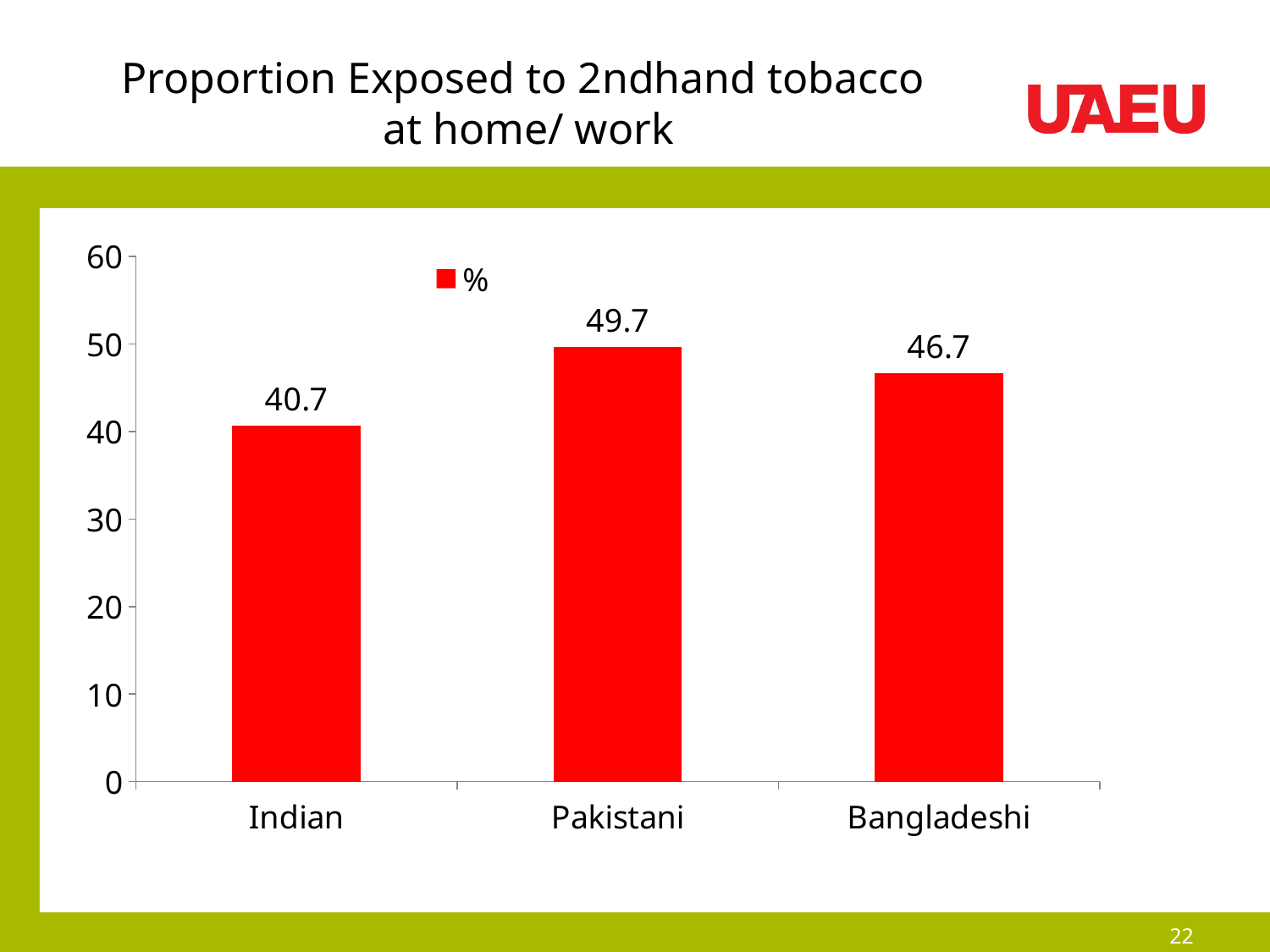
What is the difference between the values for Pakistani and Indian? 9 What is the value for Pakistani? 49.7 What is the value for Bangladeshi? 46.7 Is the value for Pakistani greater or less than 50? less What kind of chart is shown on the slide? bar chart Which category has the lowest value? Indian Which category has the highest value? Pakistani Which is larger, the value for Bangladeshi or the value for Indian? Bangladeshi What is the difference between the values for Pakistani and Bangladeshi? 3 How many categories are shown on the x axis? 3 What is the legend entry for the series shown? % What is the value for Indian? 40.7